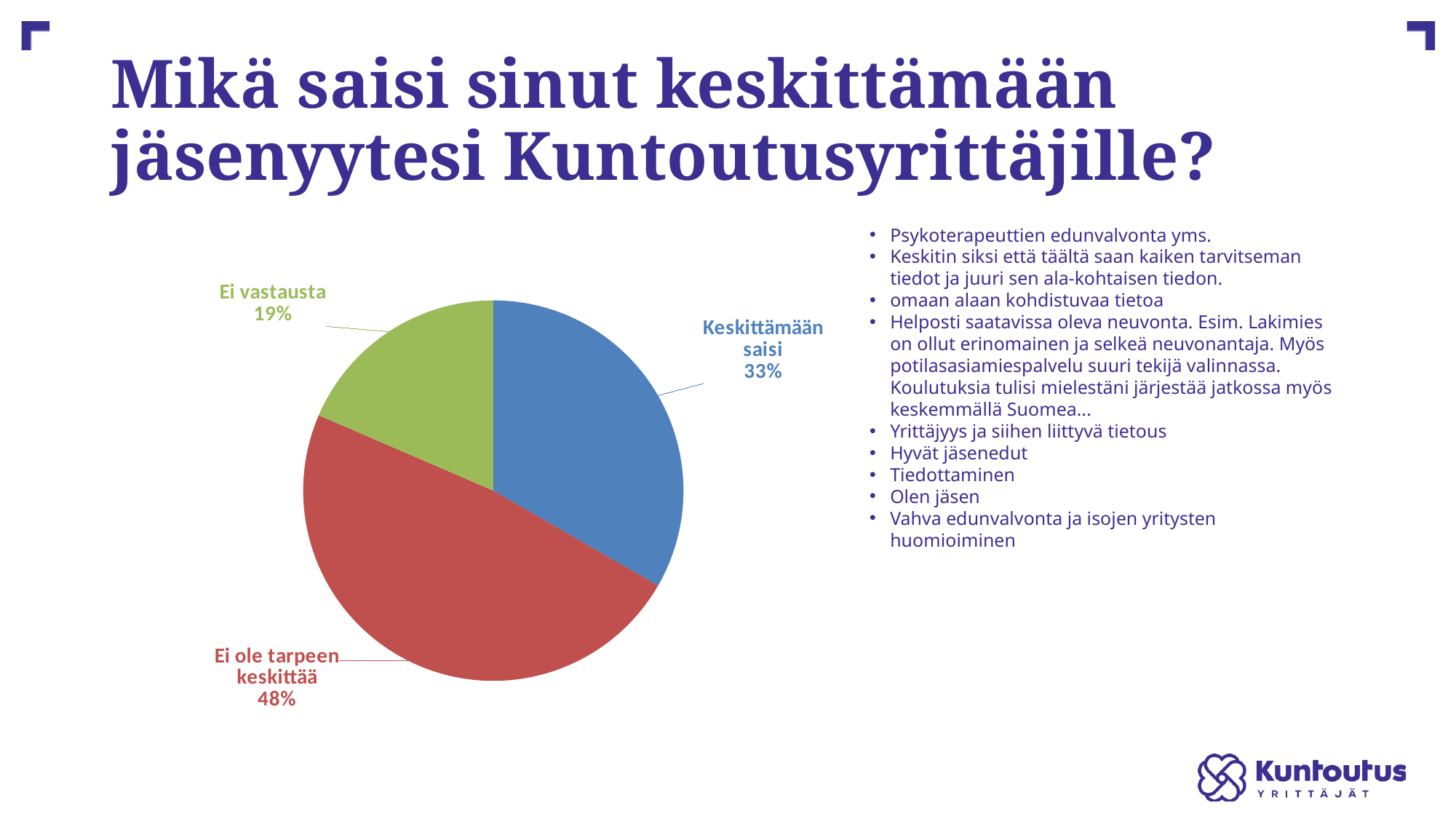
What is the difference in percentage points between "Keskittämään saisi" and "Ei vastausta"? 14 Which slice of the pie is the smallest? Ei vastausta How many slices does the pie chart have? 3 What share of the pie is labelled "Keskittämään saisi"? 33% Which slice of the pie is the largest? Ei ole tarpeen keskittää What share of the pie is labelled "Ei vastausta"? 19% What share of the pie is labelled "Ei ole tarpeen keskittää"? 48% What colour is the "Ei vastausta" slice? green What kind of chart is shown on the slide? pie chart What colour is the "Ei ole tarpeen keskittää" slice? red What is the difference in percentage points between "Ei ole tarpeen keskittää" and "Keskittämään saisi"? 15 Which is larger, the "Keskittämään saisi" slice or the "Ei vastausta" slice? Keskittämään saisi